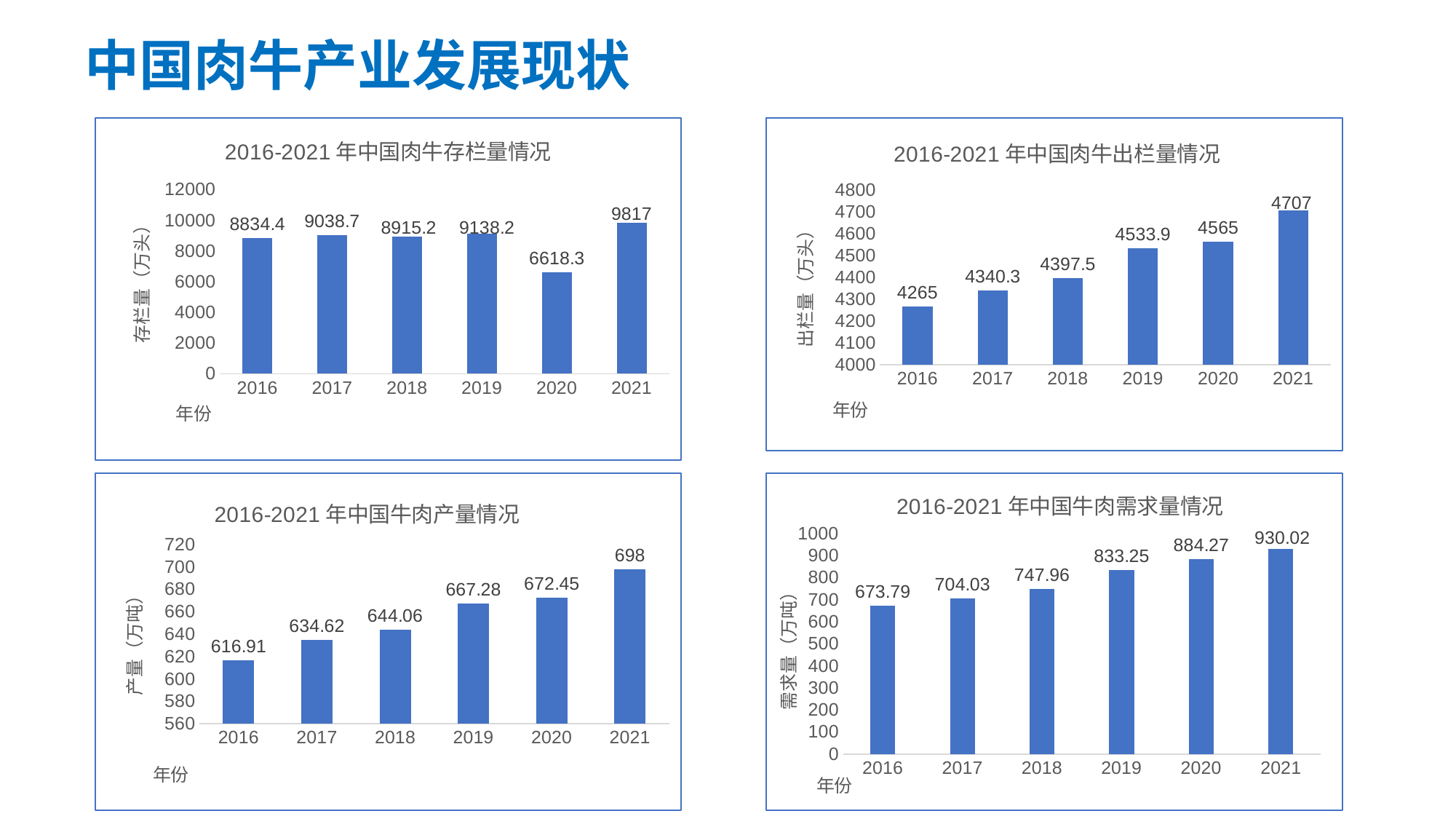
In the top-right chart (2016-2021 年中国肉牛出栏量情况), what is the value for 2018? 4397.5 In the top-left chart (2016-2021 年中国肉牛存栏量情况), what is the value for 2020? 6618.3 What kind of chart is the bottom-right chart (2016-2021 年中国牛肉需求量情况)? bar chart In the top-right chart (2016-2021 年中国肉牛出栏量情况), do the values rise or fall from 2016 to 2021? rise In the bottom-left chart (2016-2021 年中国牛肉产量情况), what is the value for 2019? 667.28 In the top-left chart (2016-2021 年中国肉牛存栏量情况), which year has the highest value? 2021 In the bottom-right chart (2016-2021 年中国牛肉需求量情况), what is the value for 2021? 930.02 In the bottom-right chart (2016-2021 年中国牛肉需求量情况), which is larger, the value for 2017 or the value for 2018? 2018 In the bottom-left chart (2016-2021 年中国牛肉产量情况), what is the difference between the 2020 and 2019 values? 5.17 In the bottom-left chart (2016-2021 年中国牛肉产量情况), how many years are shown? 6 In the top-left chart (2016-2021 年中国肉牛存栏量情况), which year has the lowest value? 2020 In the top-right chart (2016-2021 年中国肉牛出栏量情况), what is the difference between the 2021 and 2016 values? 442